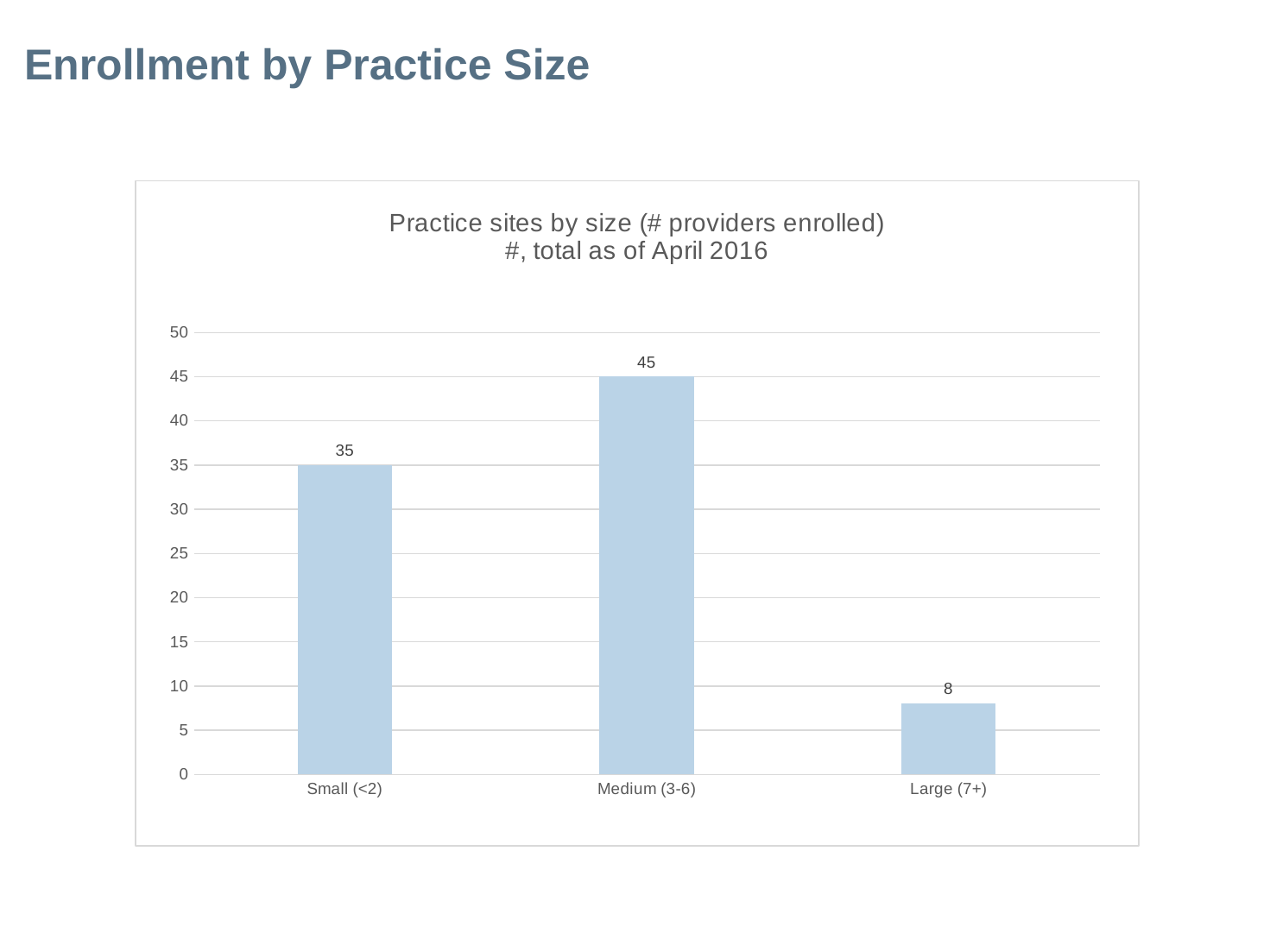
What is the value for Medium (3-6)? 45 Which is larger, the value for Small (<2) or the value for Large (7+)? Small (<2) What is the title of the chart? Practice sites by size (# providers enrolled) #, total as of April 2016 What is the difference between the values for Medium (3-6) and Small (<2)? 10 Which practice size category has the lowest number of practice sites? Large (7+) Which practice size category has the highest number of practice sites? Medium (3-6) Is the value for Medium (3-6) greater or less than 40? greater What kind of chart is shown on the slide? Bar chart What is the value for Large (7+)? 8 What is the difference between the values for Small (<2) and Large (7+)? 27 How many practice size categories are shown on the chart? 3 What is the value for Small (<2)? 35